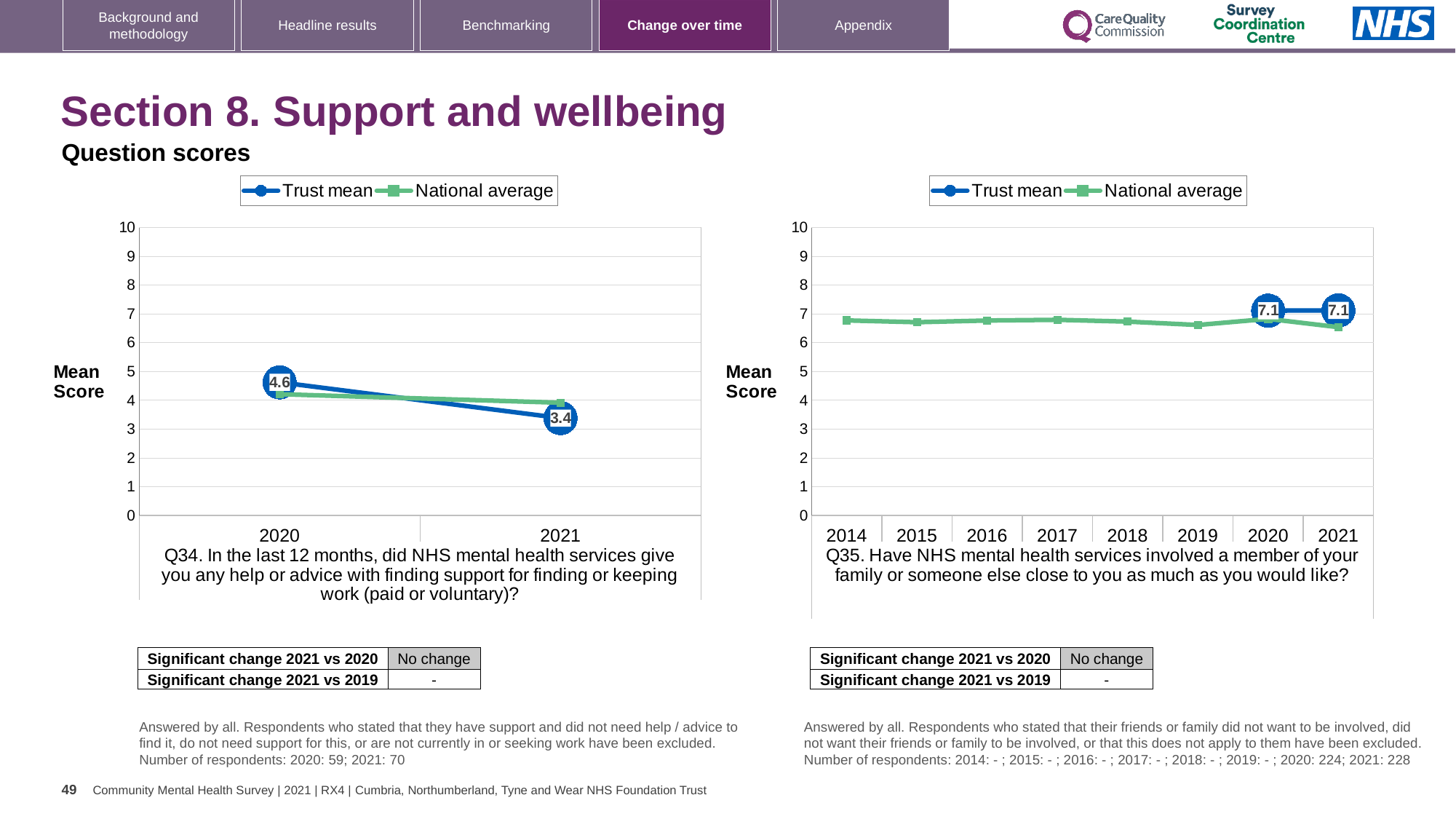
How many years are shown on the x axis of the Q35 chart on the right? 8 What are the two legend entries in the Q34 chart on the left? Trust mean and National average In the Q35 chart on the right, which is higher in 2021, the Trust mean or the National average? Trust mean In the Q35 chart on the right, what is the Trust mean for 2021? 7.1 In the Q34 chart on the left, does the Trust mean rise or fall from 2020 to 2021? fall In the Q34 chart on the left, what is the Trust mean for 2020? 4.6 In the Q34 chart on the left, by how much did the Trust mean fall from 2020 to 2021? 1.2 How many years are shown on the x axis of the Q34 chart on the left? 2 In the Q34 chart on the left, what is the Trust mean for 2021? 3.4 In the Q35 chart on the right, is the National average for 2019 greater or less than 7? less How many series does the legend of the Q34 chart on the left list? 2 What kind of chart is the Q35 chart on the right? line chart